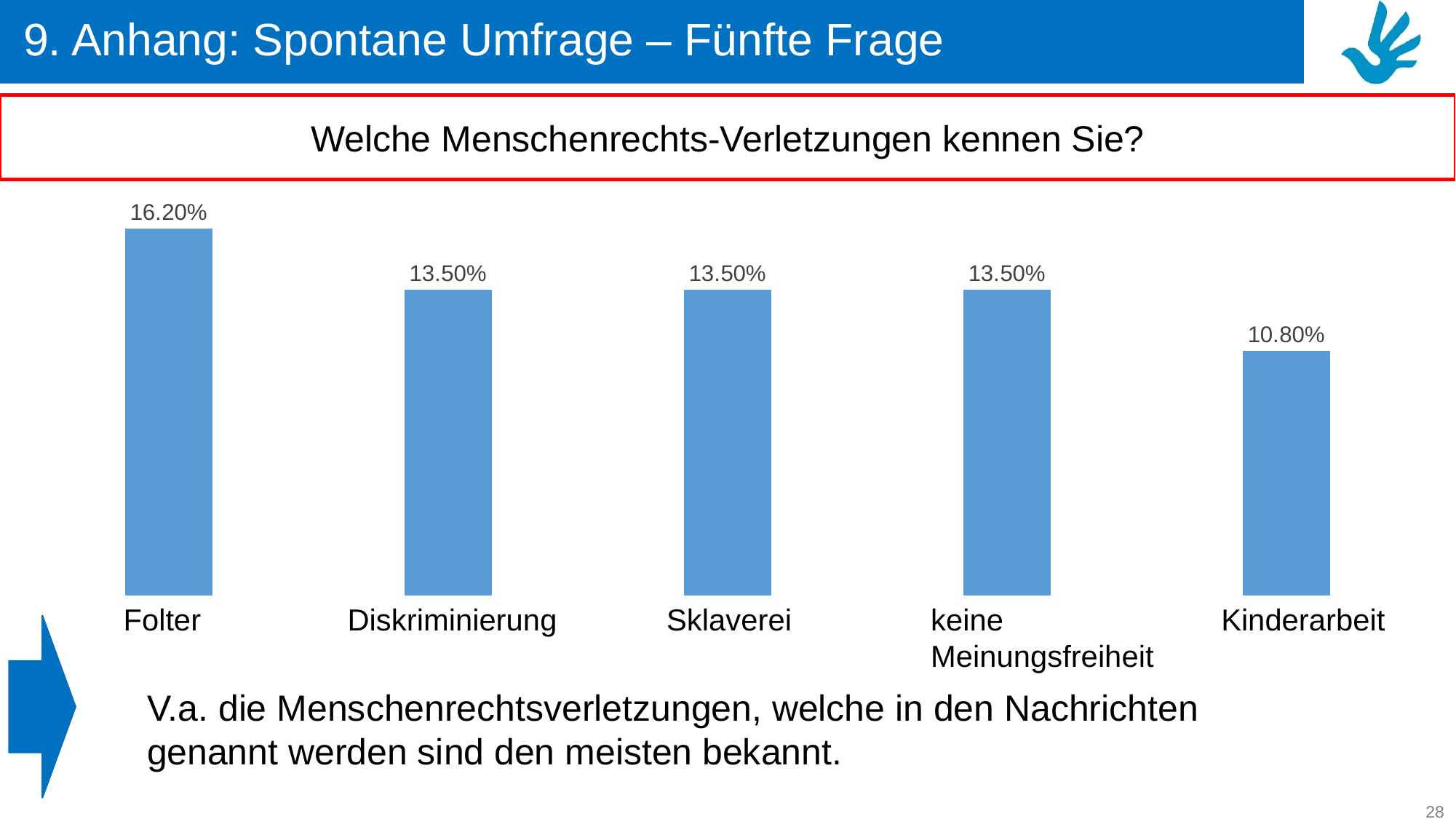
What kind of chart is shown on the slide? Bar chart What is the value for Kinderarbeit? 10.80% What is the difference between the values for Folter and Diskriminierung? 2.70% Which category has the lowest value? Kinderarbeit What is the value for Sklaverei? 13.50% Which is larger, the value for Diskriminierung or the value for Kinderarbeit? Diskriminierung What question is the chart answering, as shown in the red box above it? Welche Menschenrechts-Verletzungen kennen Sie? Which category has the highest value? Folter How many categories are shown in the chart? 5 What is the value for Folter? 16.20% What is the difference between the values for Folter and Kinderarbeit? 5.40% What is the value for keine Meinungsfreiheit? 13.50%